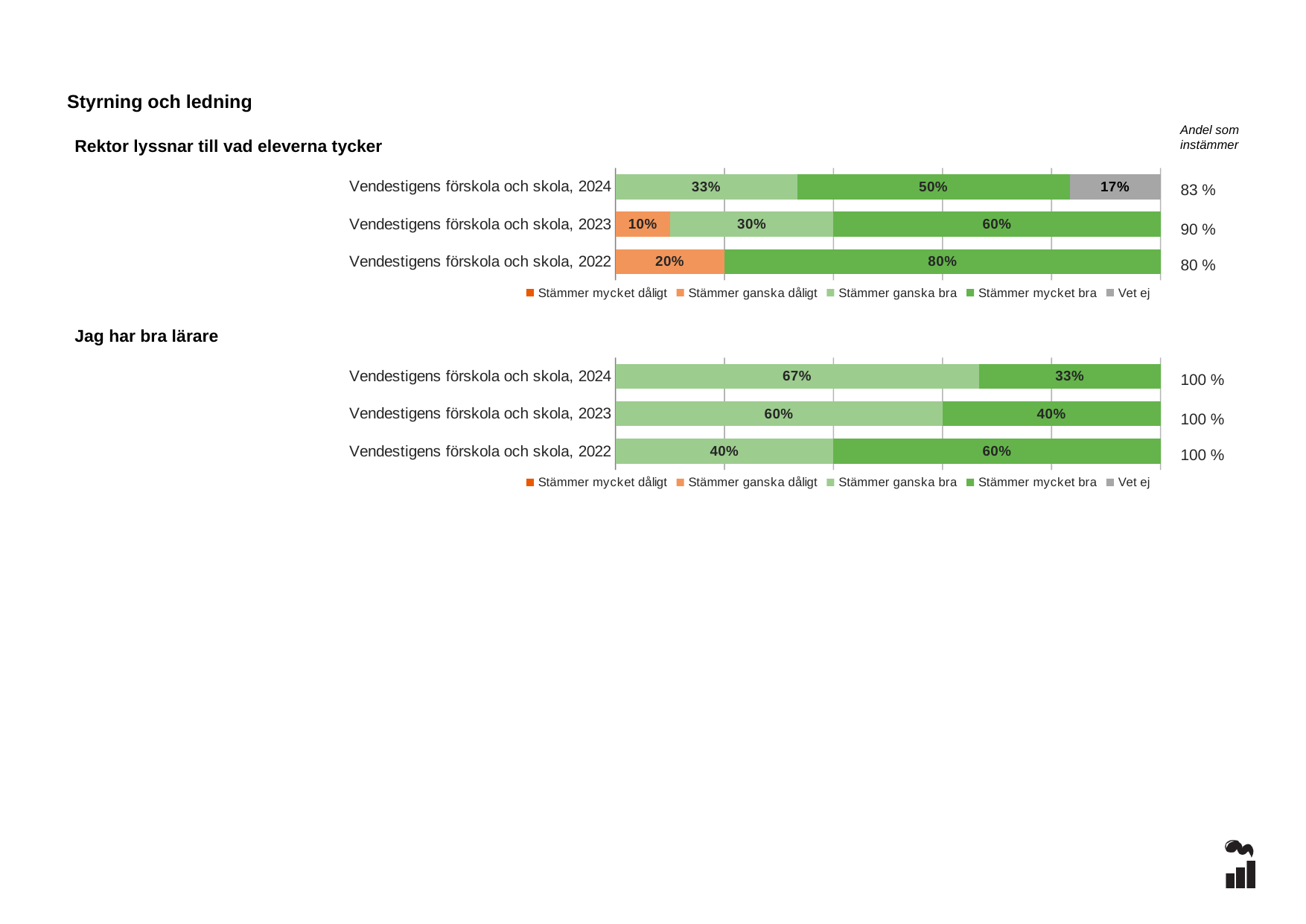
In the chart 'Jag har bra lärare', is the 'Stämmer mycket bra' value for 2023 larger or smaller than for 2024? larger In the chart 'Rektor lyssnar till vad eleverna tycker', what is the difference between the 'Stämmer mycket bra' values for 2023 and 2024? 10% In the chart 'Rektor lyssnar till vad eleverna tycker', what is the 'Andel som instämmer' for Vendestigens förskola och skola, 2023? 90 % In the chart 'Rektor lyssnar till vad eleverna tycker', what is the value of 'Stämmer mycket bra' for Vendestigens förskola och skola, 2024? 50% How many series does the legend of the chart 'Jag har bra lärare' list? 5 What kind of chart is 'Rektor lyssnar till vad eleverna tycker'? Stacked bar chart In the chart 'Rektor lyssnar till vad eleverna tycker', what is the value of 'Vet ej' for Vendestigens förskola och skola, 2024? 17% In the chart 'Rektor lyssnar till vad eleverna tycker', which year has the highest 'Stämmer mycket bra' value? Vendestigens förskola och skola, 2022 In the chart 'Jag har bra lärare', what is the total of the stacked bar for Vendestigens förskola och skola, 2022? 100% In the chart 'Jag har bra lärare', which year has the lowest 'Stämmer ganska bra' value? Vendestigens förskola och skola, 2022 In the chart 'Jag har bra lärare', what is the value of 'Stämmer ganska bra' for Vendestigens förskola och skola, 2024? 67% In the chart 'Rektor lyssnar till vad eleverna tycker', what is the value of 'Stämmer ganska dåligt' for Vendestigens förskola och skola, 2022? 20%